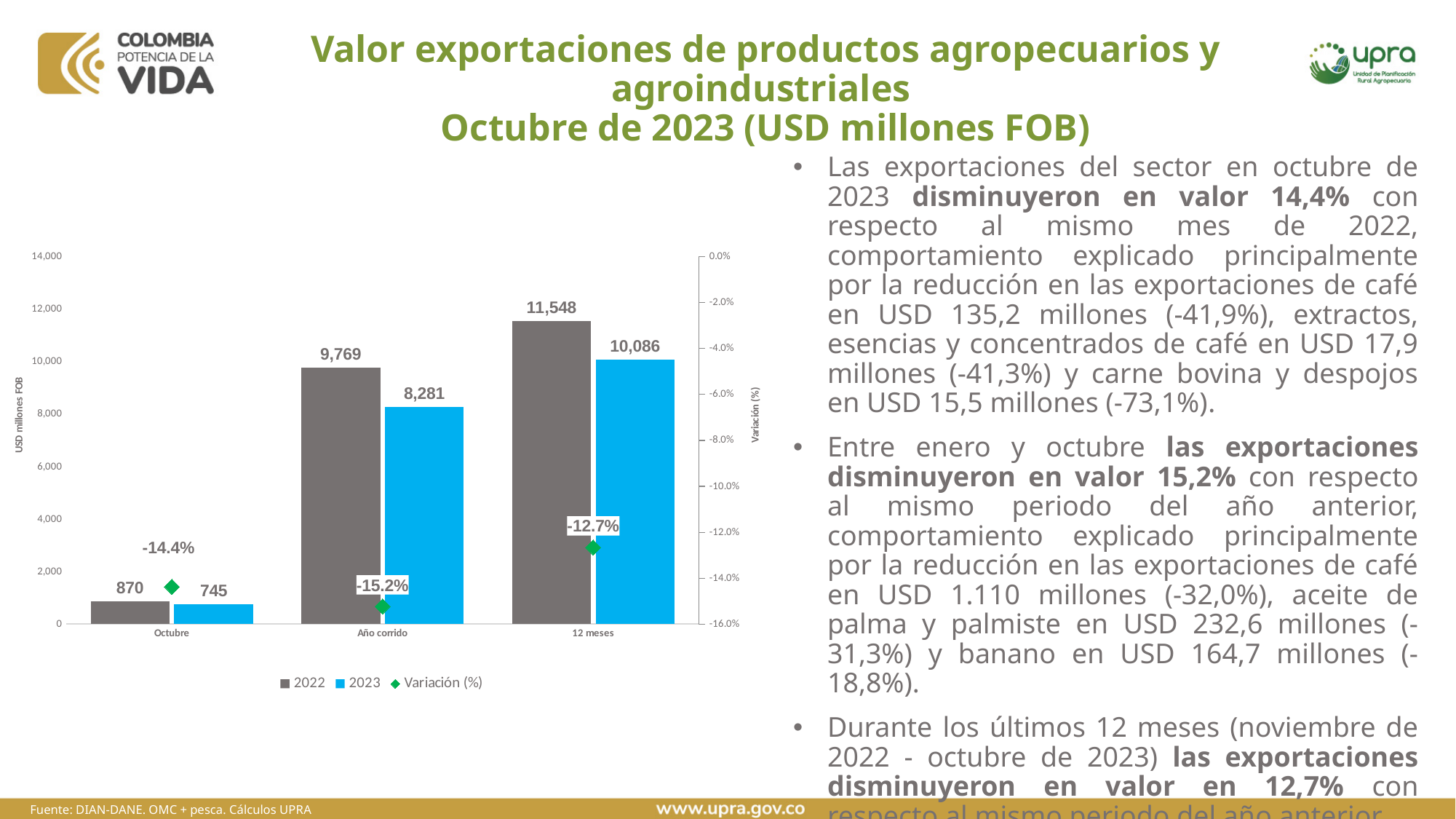
Which is larger for Octubre, the 2022 value or the 2023 value? 2022 What is the label of the left vertical axis? USD millones FOB What kind of chart is shown on the slide? Bar chart with a line/marker series What is the difference between the 2022 and 2023 values for 12 meses? 1,462 How many categories are shown on the x axis? 3 What is the Variación (%) for Año corrido? -15.2% Which category has the highest 2023 value? 12 meses How many series does the legend list? 3 What is the 2022 value for 12 meses? 11,548 Which category has the lowest 2022 value? Octubre What is the 2023 value for Año corrido? 8,281 What is the 2022 value for Octubre? 870